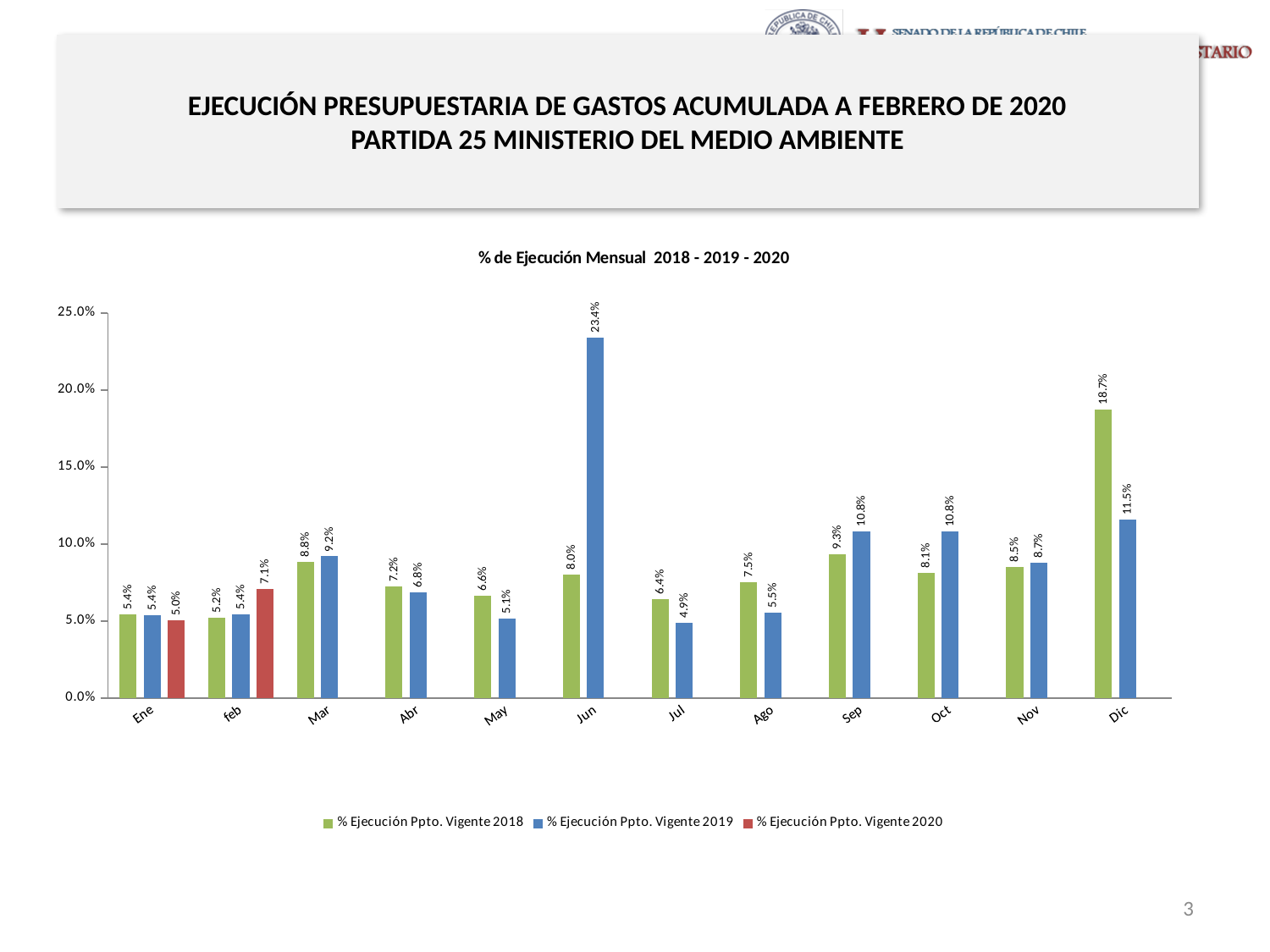
What is the difference between the 2019 and 2018 values for Jun? 15.4% How many months are shown on the x axis? 12 What is the value of % Ejecución Ppto. Vigente 2019 for Jun? 23.4% Which month has the lowest value for % Ejecución Ppto. Vigente 2019? Jul How many series does the legend list? 3 Which is larger for Oct: the 2018 value or the 2019 value? 2019 Which month has the highest value for % Ejecución Ppto. Vigente 2018? Dic What is the value of % Ejecución Ppto. Vigente 2018 for Dic? 18.7% What kind of chart is shown on the slide? Bar chart What is the title of the chart? % de Ejecución Mensual 2018 - 2019 - 2020 What is the value of % Ejecución Ppto. Vigente 2020 for feb? 7.1% Is the value of % Ejecución Ppto. Vigente 2019 for Dic greater or less than 10.0%? greater